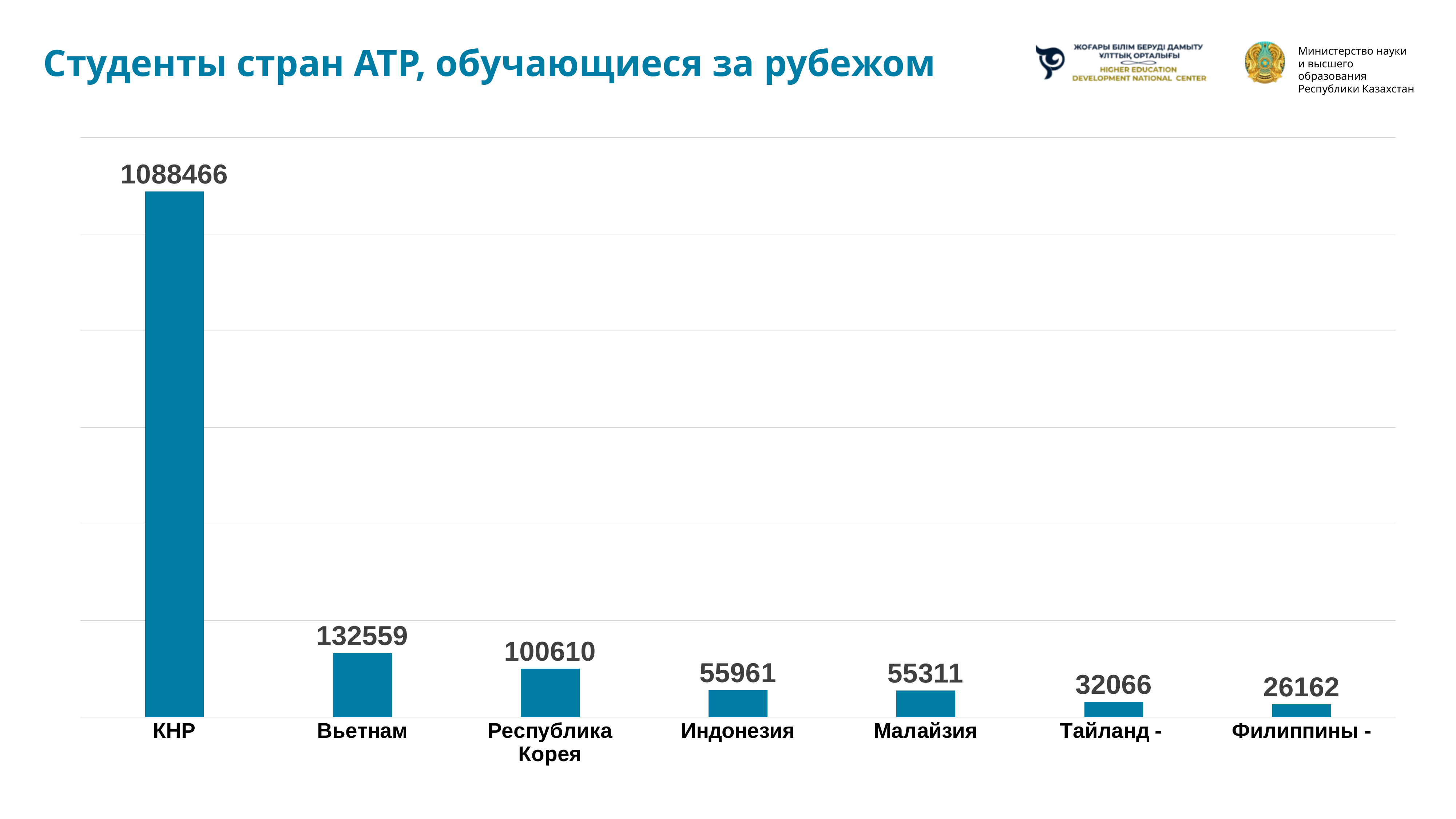
Which category has the lowest value? Филиппины What is the value for Малайзия? 55311 Which category has the highest value? КНР What is the value for Филиппины? 26162 What is the value for Республика Корея? 100610 What is the difference between the values for КНР and Вьетнам? 955907 What is the value for Вьетнам? 132559 What is the difference between the values for Тайланд and Филиппины? 5904 What is the value for КНР? 1088466 Which is larger, the value for Вьетнам or the value for Республика Корея? Вьетнам What kind of chart is shown on the slide? Bar chart How many categories are shown in the chart? 7